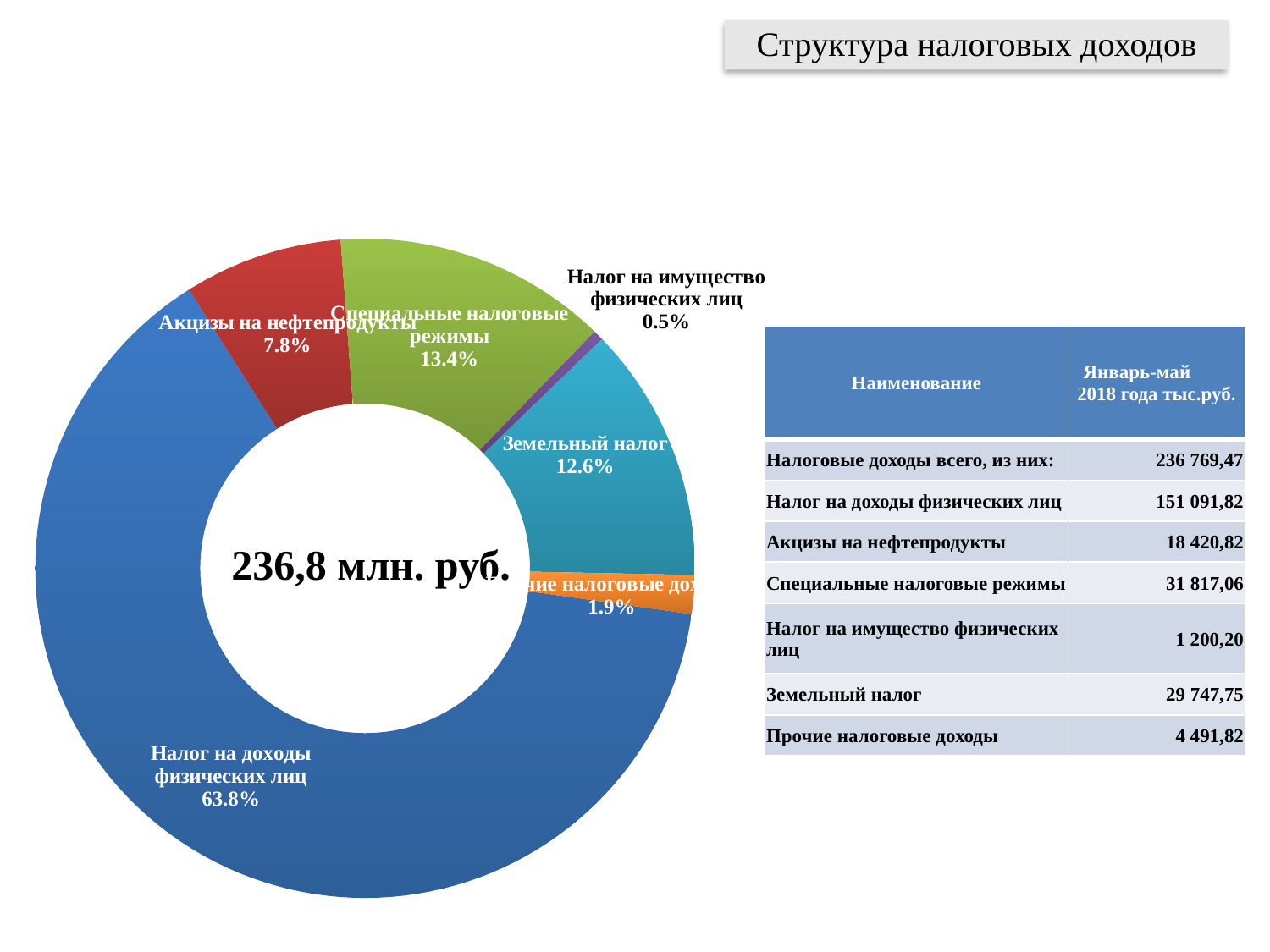
What kind of chart is shown on the slide? Doughnut (pie) chart What is the difference in percentage points between Специальные налоговые режимы and Акцизы на нефтепродукты in the chart? 5.6 Which category has the largest share in the chart? Налог на доходы физических лиц Which category has the smallest share in the chart? Налог на имущество физических лиц What percentage is shown for Акцизы на нефтепродукты in the chart? 7.8% Which share is larger in the chart: Специальные налоговые режимы or Земельный налог? Специальные налоговые режимы What percentage is shown for Земельный налог in the chart? 12.6% What share of tax revenues does Налог на доходы физических лиц account for in the chart? 63.8% What percentage is shown for Специальные налоговые режимы in the chart? 13.4% How many slices does the chart have? 6 What percentage is shown for Налог на имущество физических лиц in the chart? 0.5% What total value is printed in the centre of the chart? 236,8 млн. руб.